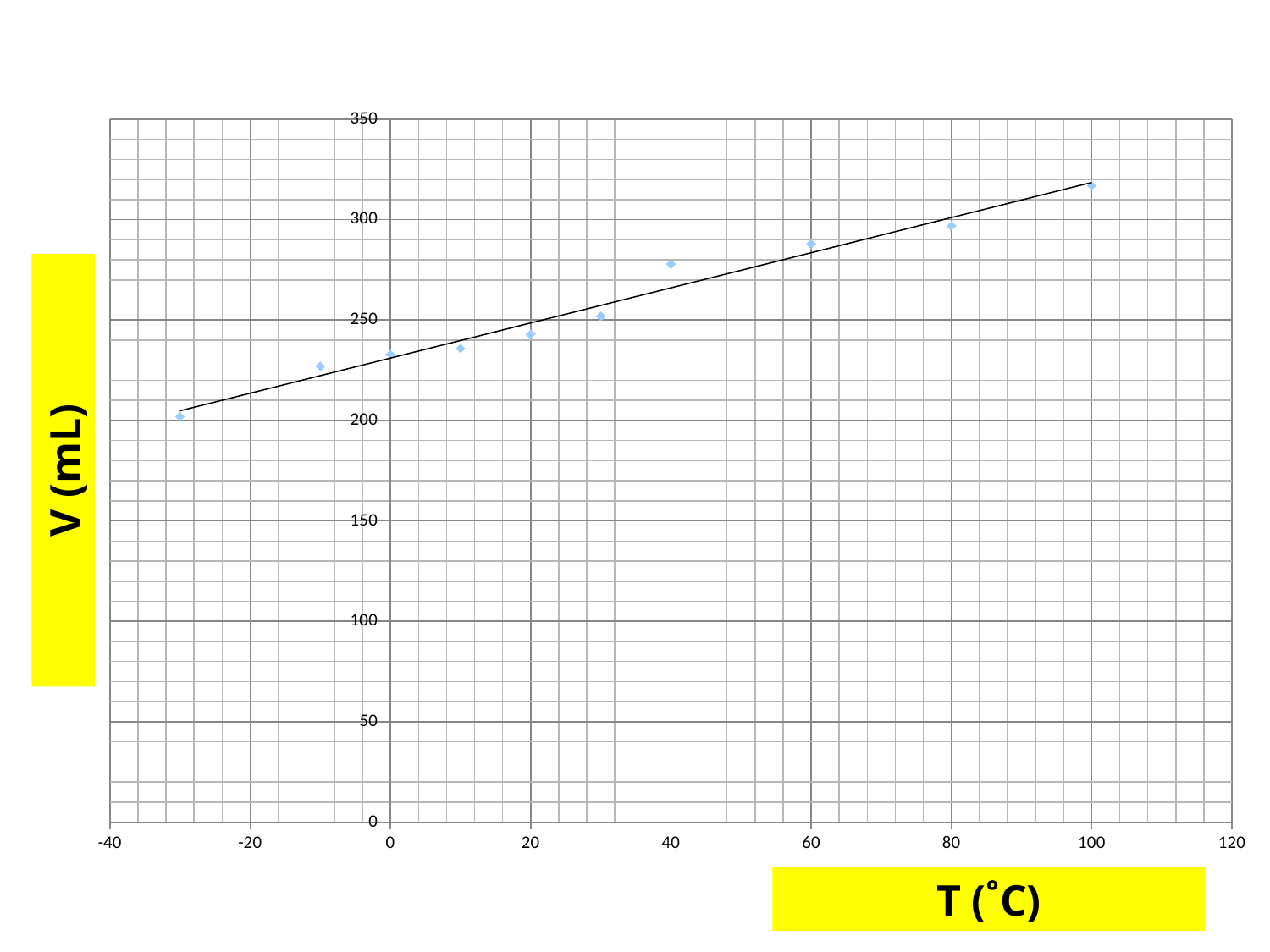
What is the label on the horizontal axis? T (°C) Is the value for T = 100 greater or less than 300? greater At which temperature is the plotted volume lowest? -30 At which temperature is the plotted volume highest? 100 Is the value for T = 60 greater or less than 250? greater Which has the larger volume, the point at T = 60 or the point at T = 0? T = 60 Do the plotted values rise or fall as T increases along the x axis? rise Is the value for T = -30 greater or less than 250? less What kind of chart is shown on the slide? scatter plot How many data points are plotted on the chart? 10 What is the label on the vertical axis? V (mL)